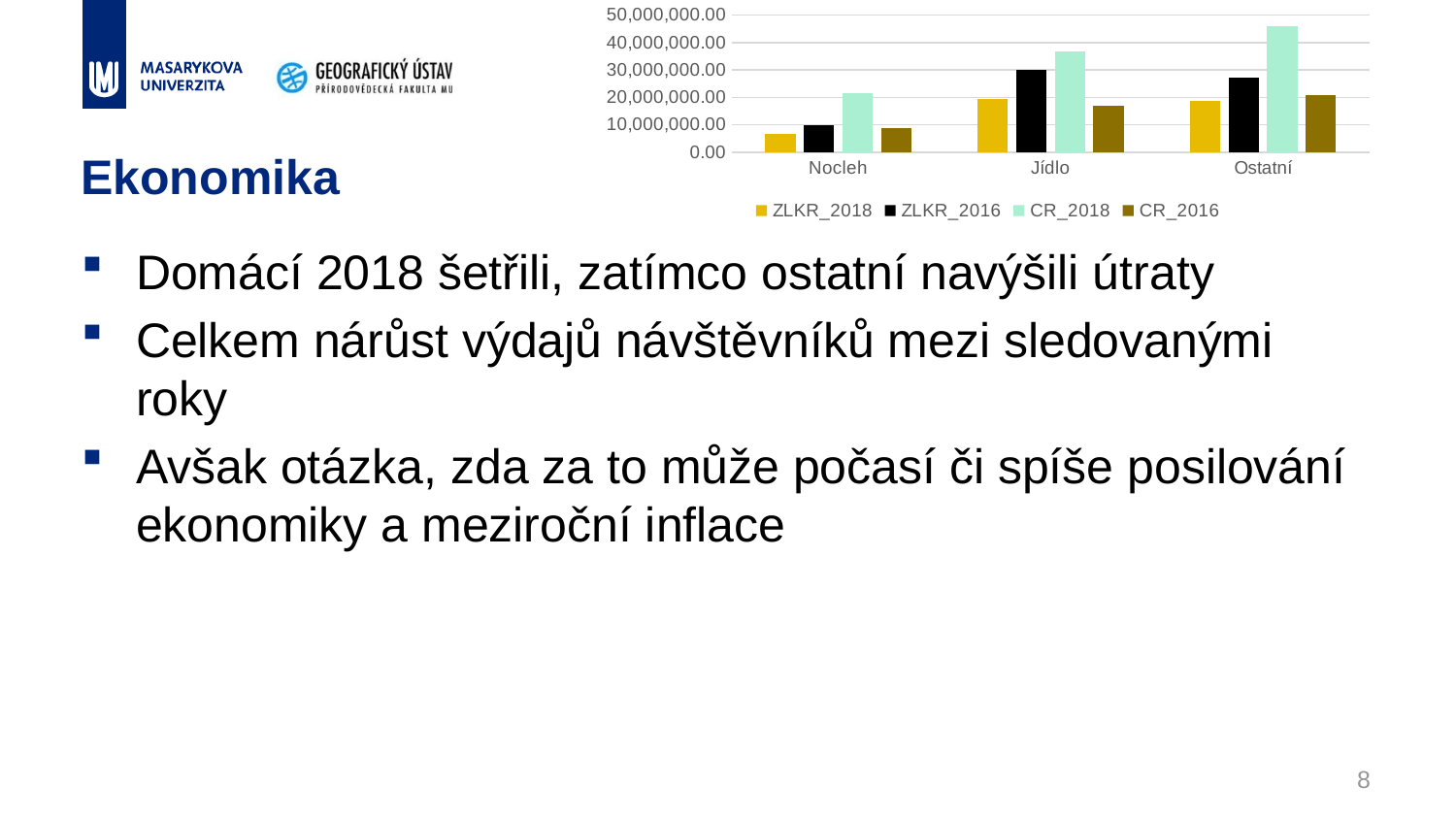
In the Nocleh category, which is larger: ZLKR_2016 or CR_2018? CR_2018 What kind of chart is shown on the slide? bar chart Is the value for ZLKR_2018 in the Nocleh category greater or less than 10,000,000.00? less Do the values for the CR_2018 series rise or fall from Nocleh to Ostatní? rise Which series has the lowest value in the Nocleh category? ZLKR_2018 Which category has the tallest bar for the CR_2018 series? Ostatní Which series is shown in black in the chart? ZLKR_2016 How many series does the chart legend list? 4 Which series has the highest value in the Jídlo category? CR_2018 Is the value for CR_2018 in the Ostatní category greater or less than 40,000,000.00? greater How many categories are shown on the x axis of the chart? 3 Is the value for ZLKR_2016 in the Jídlo category greater or less than 20,000,000.00? greater